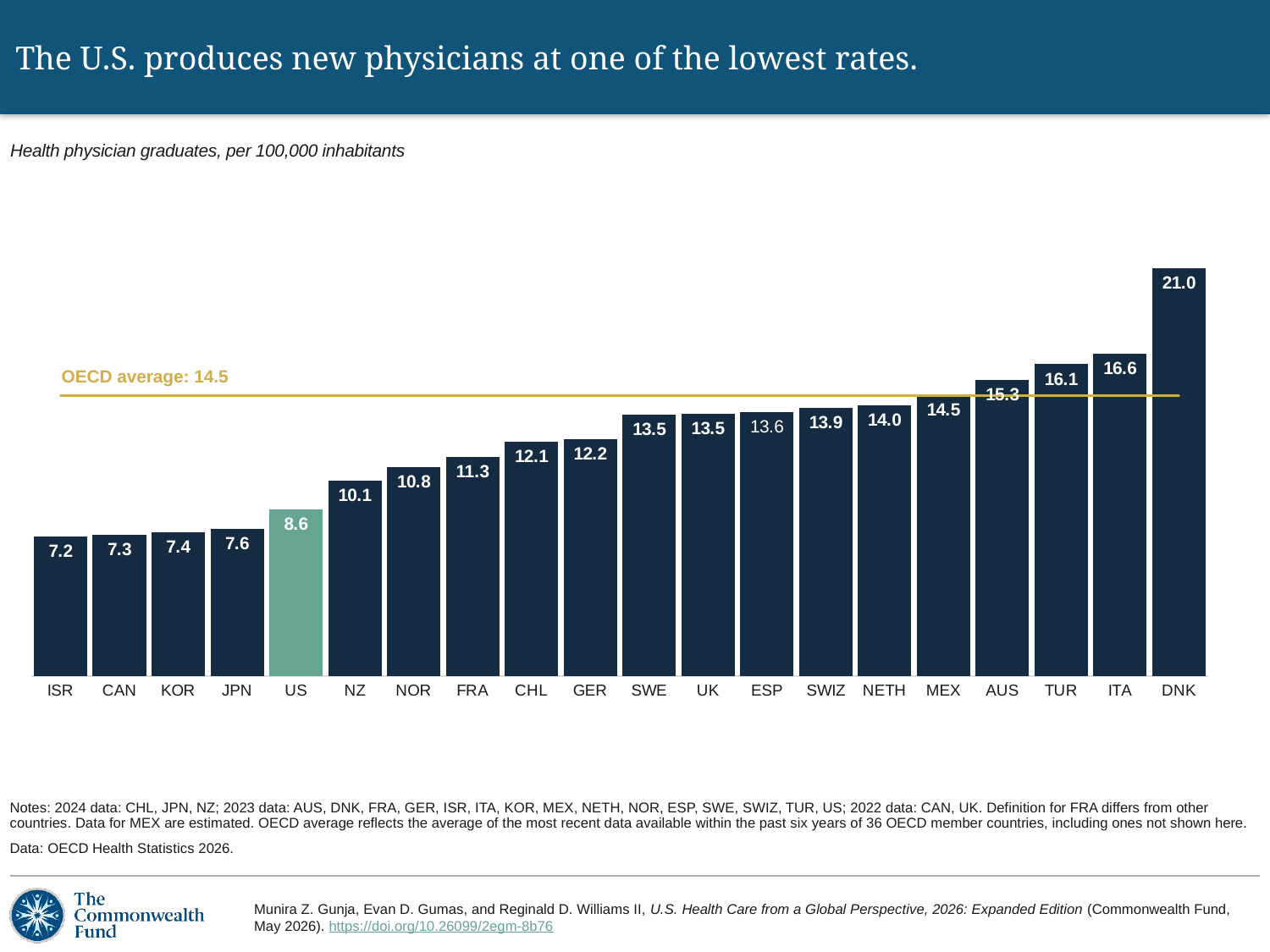
What is the value for GER? 12.2 What OECD average is marked by the horizontal line on the chart? 14.5 How many countries are shown in the chart? 20 What is the value for the US? 8.6 Which country has the highest value? DNK What kind of chart is shown on the slide? Bar chart Which country has the lowest value? ISR What is the value for DNK? 21.0 What is the difference between the values for ITA and TUR? 0.5 What is the difference between the values for DNK and the US? 12.4 Do the values rise or fall from left to right along the x axis? Rise Which is larger, the value for NOR or the value for FRA? FRA